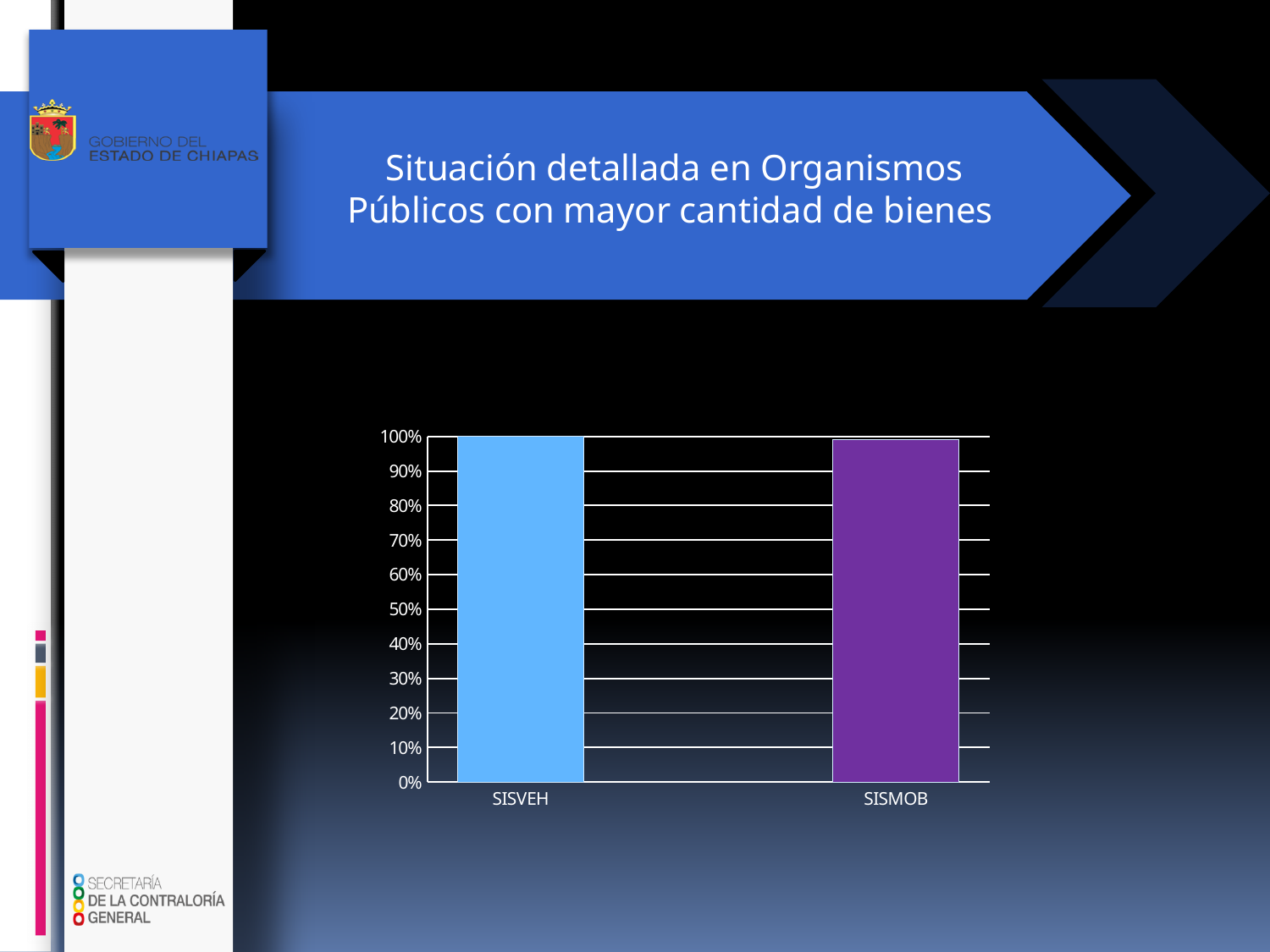
Is the value for SISMOB greater or less than 90%? greater Which category is shown on the right of the chart? SISMOB Which category is shown on the left of the chart? SISVEH Is the value for SISVEH greater or less than 50%? greater What is the value for SISVEH in the chart? 100% How many categories are shown on the x axis of the chart? 2 What is the highest value shown on the y axis of the chart? 100% What colour is the bar for SISMOB? purple What kind of chart is shown on the slide? bar chart Is the value for SISMOB greater or less than 50%? greater